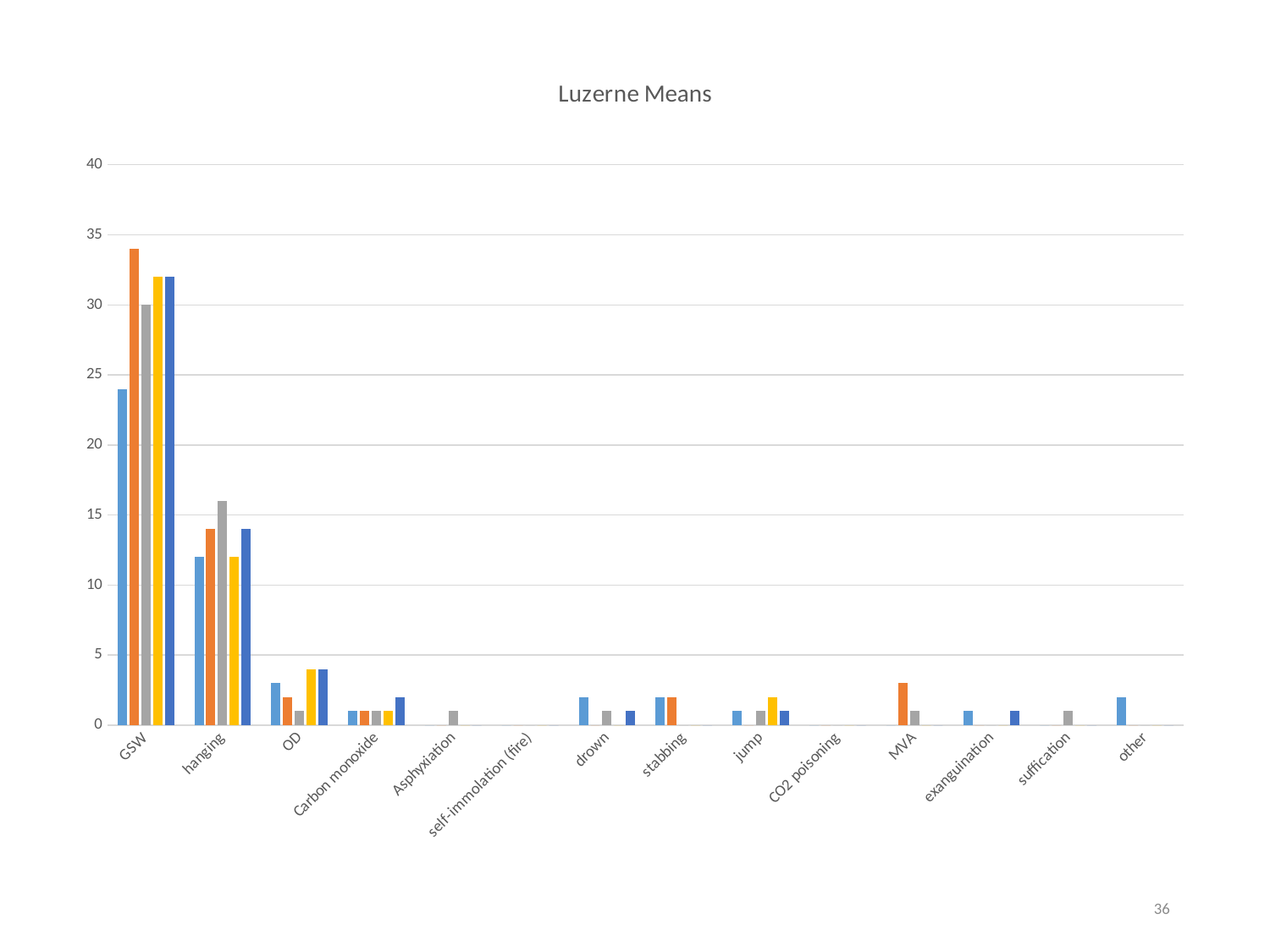
Which is larger, the orange bar for GSW or the orange bar for hanging? GSW Is the tallest bar for hanging greater or less than 20? less Is the orange bar for GSW greater or less than 30? greater How many categories are shown along the x axis? 14 Is the light blue bar for hanging greater or less than 10? greater What kind of chart is shown on the slide? bar chart Which category has the tallest bars? GSW How many different bar colours are used in the chart? 5 What is the title of the chart? Luzerne Means